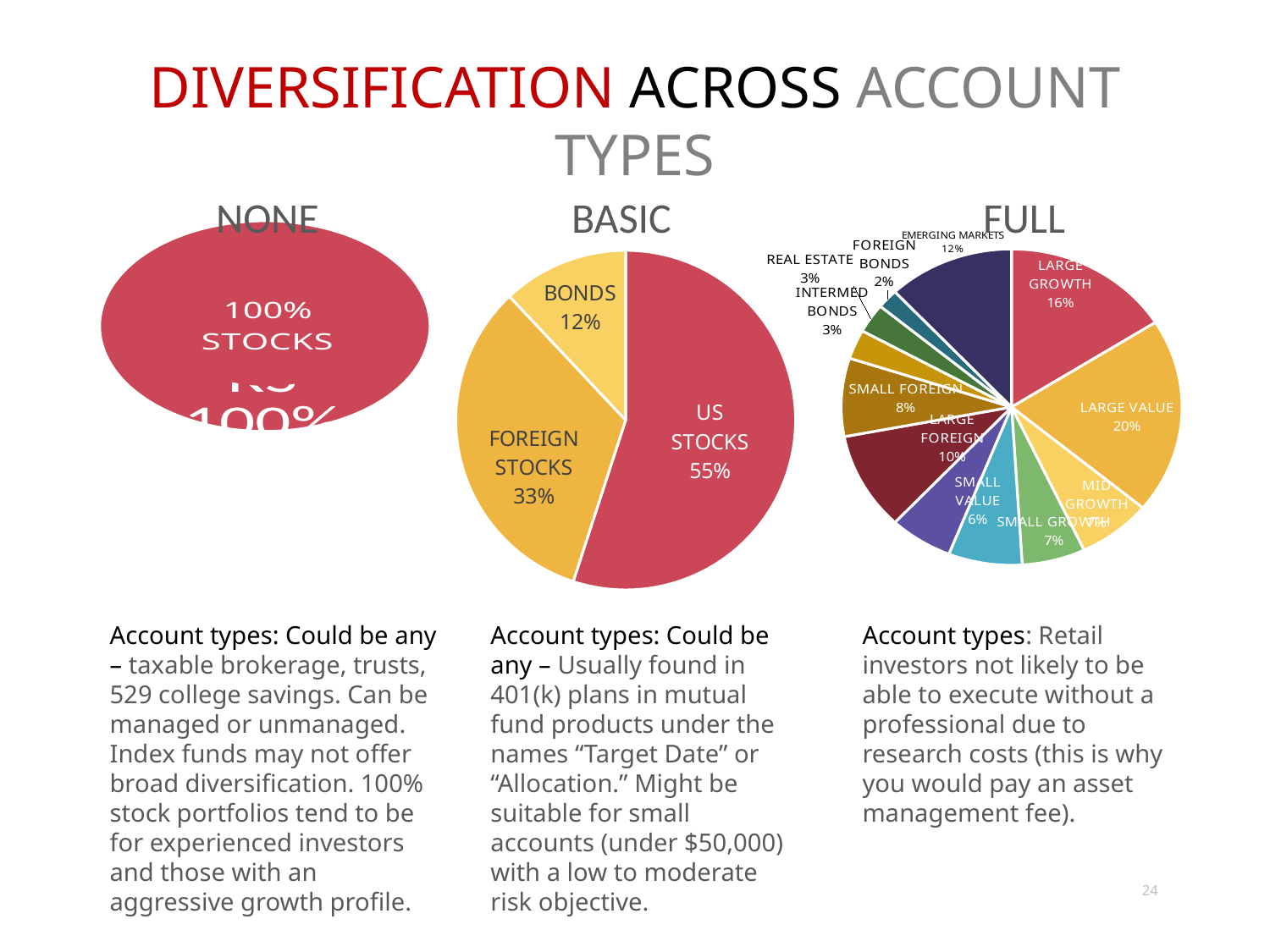
In the BASIC pie chart, what share is Foreign Stocks? 33% What kind of chart is used for the BASIC allocation? Pie chart How many categories does the BASIC pie chart show? 3 In the BASIC pie chart, what share is Bonds? 12% In the BASIC pie chart, what share is US Stocks? 55% In the BASIC pie chart, which category has the largest slice? US Stocks In the FULL pie chart, which is larger, Large Value or Large Growth? Large Value In the NONE pie chart, what share is Stocks? 100% In the BASIC pie chart, which category has the smallest slice? Bonds In the FULL pie chart, what share is Large Growth? 16% In the FULL pie chart, what share is Large Value? 20% In the BASIC pie chart, how much larger is the US Stocks share than the Foreign Stocks share? 22%